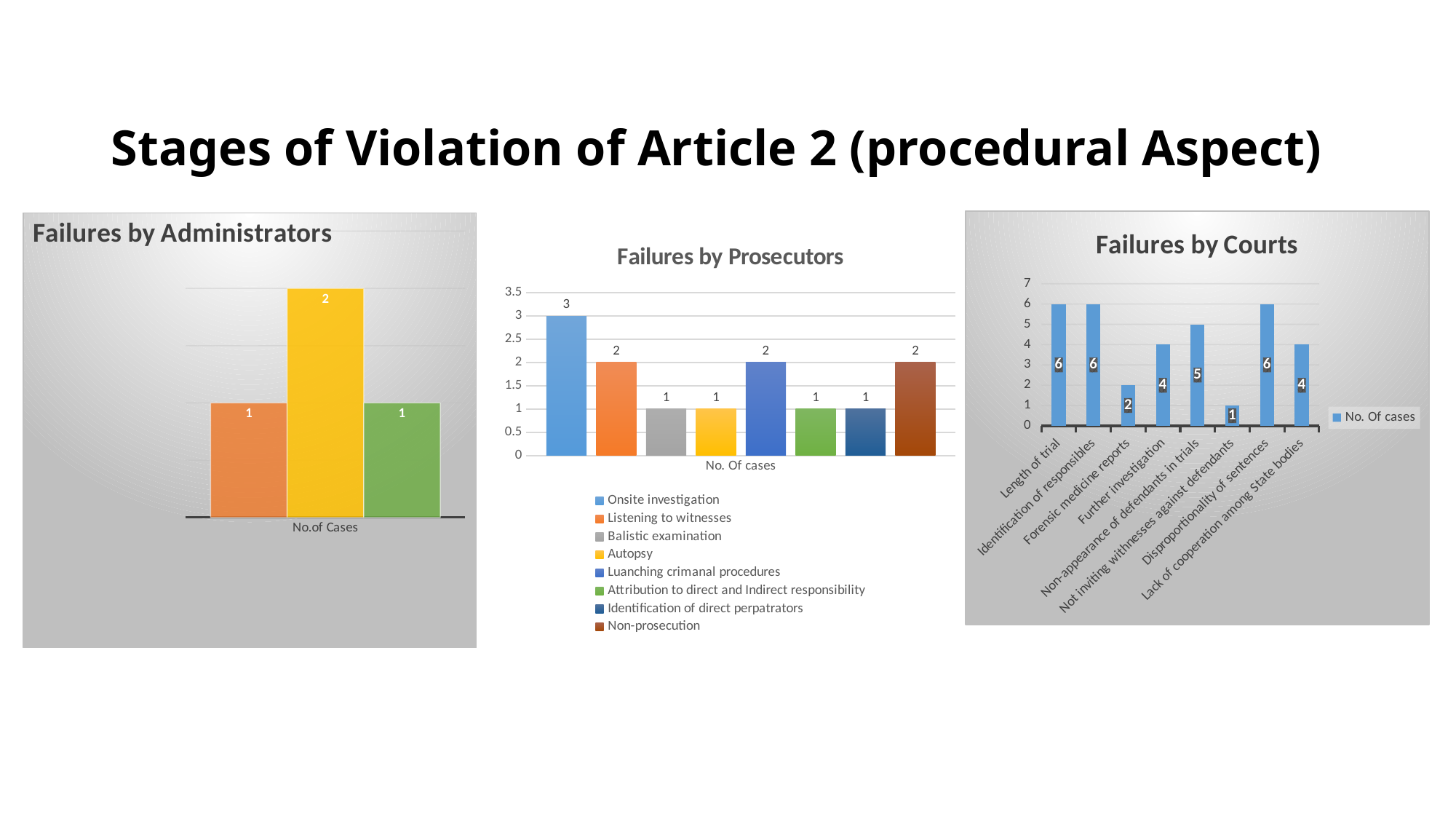
In the 'Failures by Prosecutors' chart, what is the value for Non-prosecution? 2 In the 'Failures by Prosecutors' chart, what is the value for Onsite investigation? 3 In the 'Failures by Prosecutors' chart, what is the difference between Onsite investigation and Balistic examination? 2 In the 'Failures by Administrators' chart, how many bars are plotted? 3 In the 'Failures by Prosecutors' chart, which series has the highest value? Onsite investigation In the 'Failures by Courts' chart, which category has the lowest value? Not inviting withnesses against defendants In the 'Failures by Courts' chart, what is the value for Further investigation? 4 What kind of chart is 'Failures by Administrators'? Bar chart In the 'Failures by Courts' chart, which is larger: Non-appearance of defendants in trials or Lack of cooperation among State bodies? Non-appearance of defendants in trials In the 'Failures by Courts' chart, what is the difference between Length of trial and Forensic medicine reports? 4 In the 'Failures by Courts' chart, how many categories are shown on the x axis? 8 In the 'Failures by Prosecutors' chart, how many series does the legend list? 8